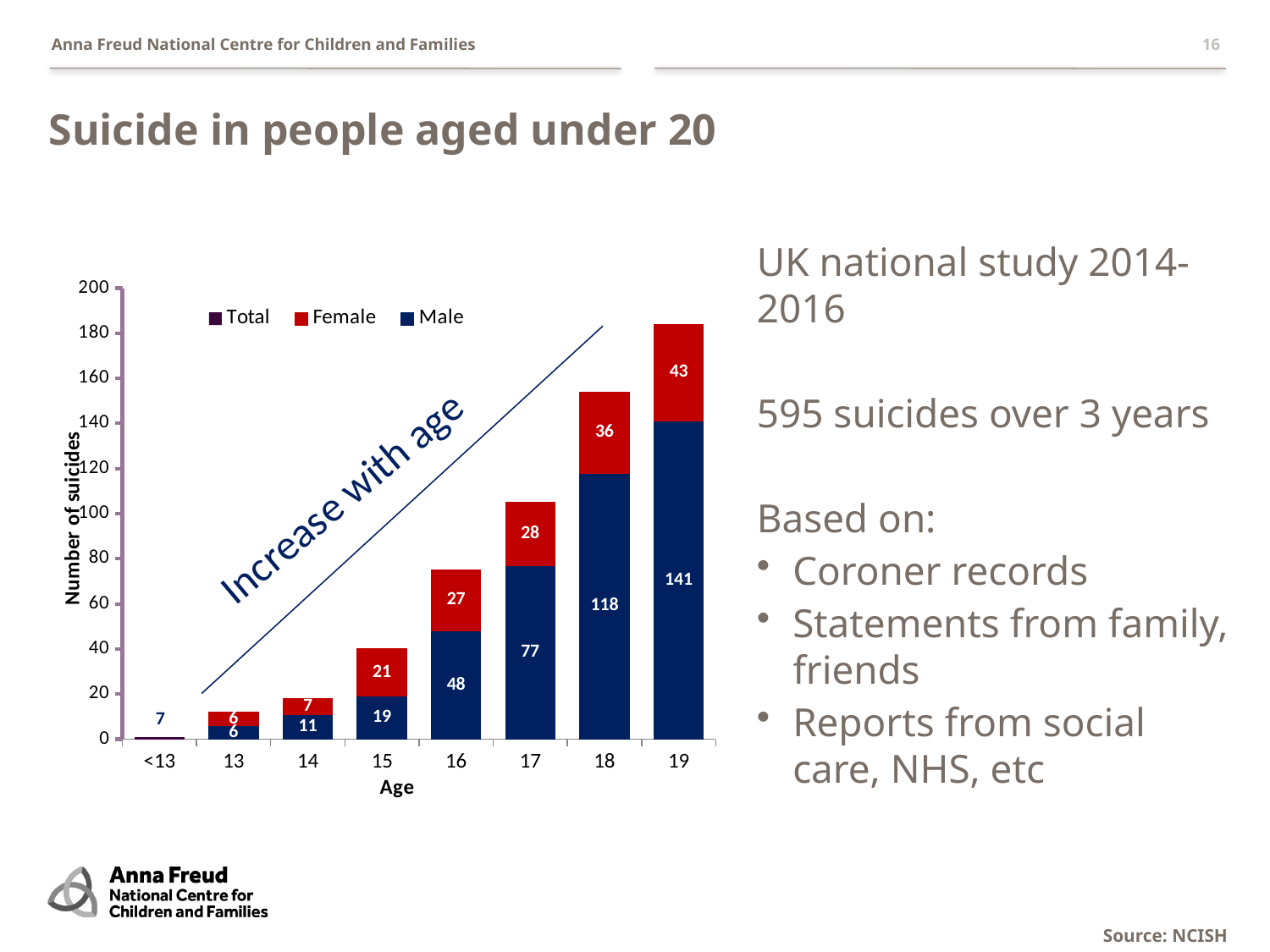
What is the Female value for age 18? 36 What is the Female value for age 15? 21 What is the Male value for age 16? 48 What kind of chart is shown on the slide? Stacked bar chart What is the Male value for age 19? 141 Which age category has the lowest Female value? 13 What is the total of the stacked bar for age 18 (Male plus Female)? 154 How many series does the legend list? 3 Which age category has the highest Male value? 19 Which is larger, the Female value for age 17 or the Female value for age 16? Female value for age 17 What is the difference between the Male values for age 19 and age 18? 23 How many age categories are shown on the x axis? 8